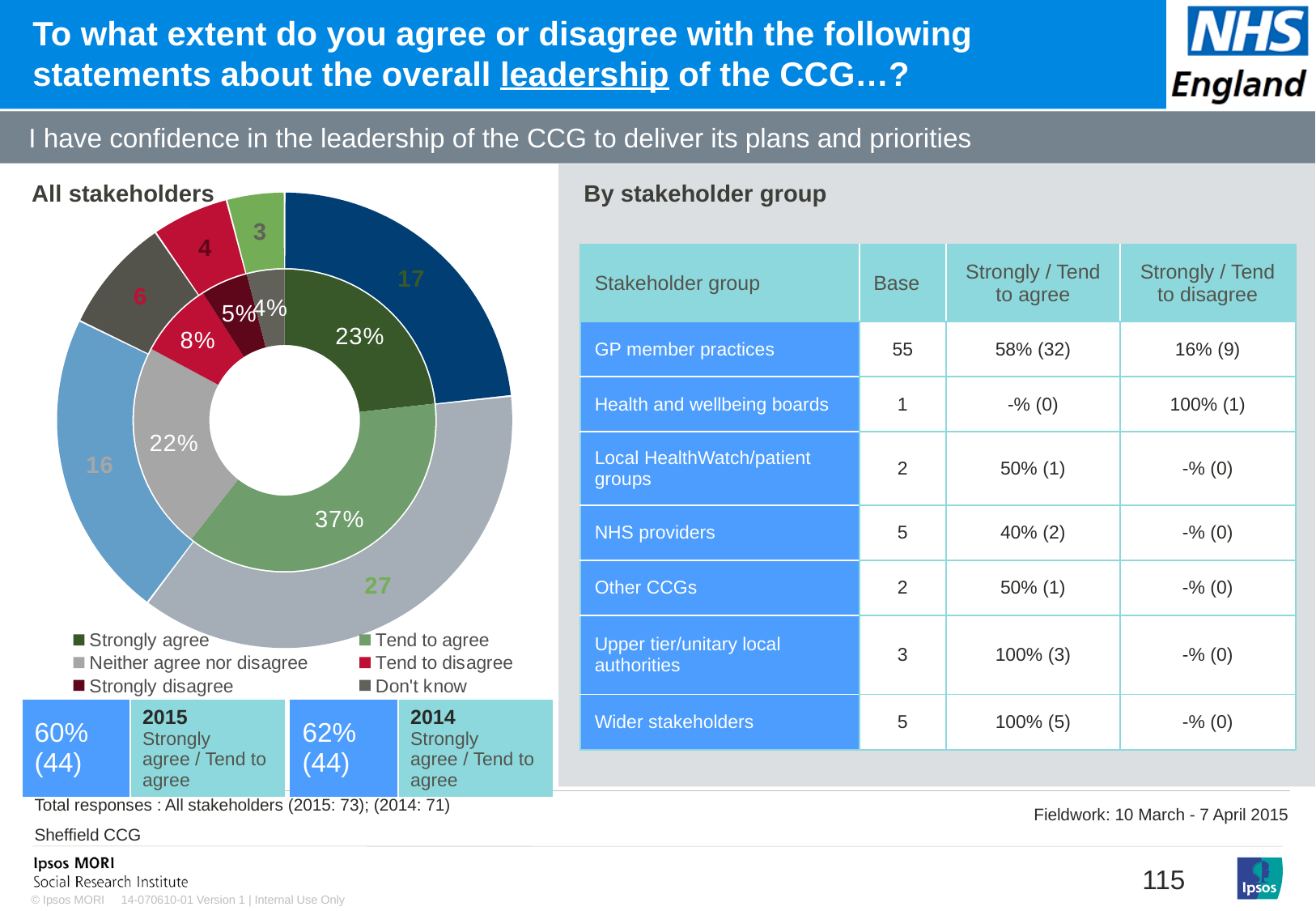
What type of chart is used to show the 'All stakeholders' results? Doughnut chart What percentage of all stakeholders 'Strongly agree' in the doughnut chart? 23% In the doughnut chart, which is larger: 'Neither agree nor disagree' or 'Tend to disagree'? Neither agree nor disagree What colour represents 'Tend to disagree' in the doughnut chart legend? Red What percentage of all stakeholders 'Tend to agree' in the doughnut chart? 37% In the doughnut chart, what is the difference in percentage points between 'Tend to agree' and 'Strongly agree'? 14 Which response category has the largest share in the 'All stakeholders' doughnut chart? Tend to agree What percentage of all stakeholders answered 'Don't know' in the doughnut chart? 4% Which response category has the smallest share in the 'All stakeholders' doughnut chart? Don't know In the doughnut chart, how many respondents 'Neither agree nor disagree' according to the outer ring? 16 In the doughnut chart, what is the combined percentage of 'Tend to disagree' and 'Strongly disagree'? 13% How many response categories does the legend of the doughnut chart list? 6